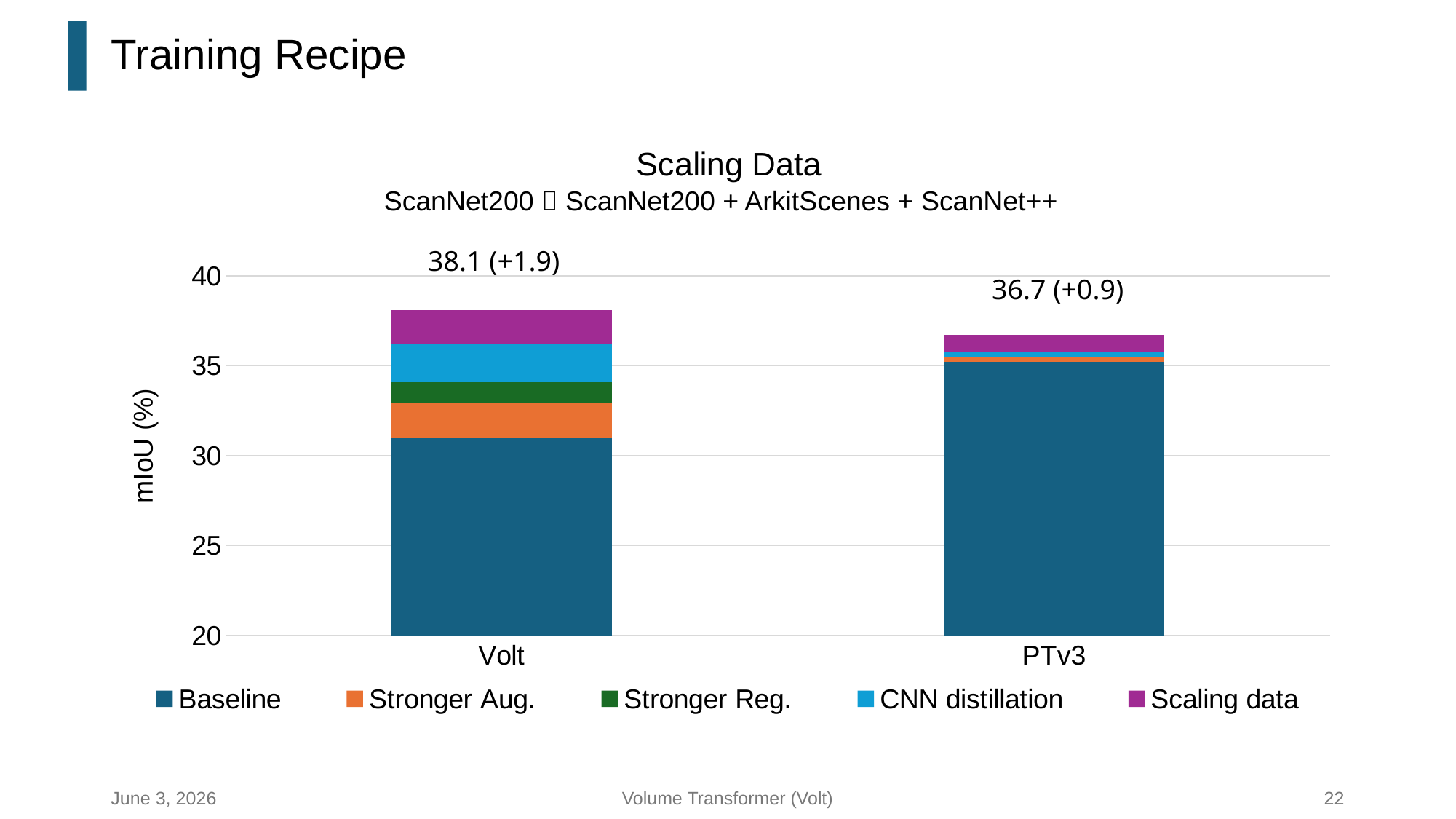
How many models (categories) are shown on the x axis? 2 What gain from scaling data is shown in parentheses above the PTv3 bar? +0.9 Is the Baseline value for PTv3 greater or less than 30? greater What is the total mIoU value labelled on the Volt bar? 38.1 What is the total mIoU value labelled on the PTv3 bar? 36.7 What type of chart is shown on the slide? Stacked bar chart What is the difference between the total mIoU of Volt and PTv3? 1.4 Which model has the larger Baseline segment, Volt or PTv3? PTv3 Which model has the higher total mIoU, Volt or PTv3? Volt Is the Baseline value for Volt greater or less than 35? less What gain from scaling data is shown in parentheses above the Volt bar? +1.9 How many series does the legend list? 5